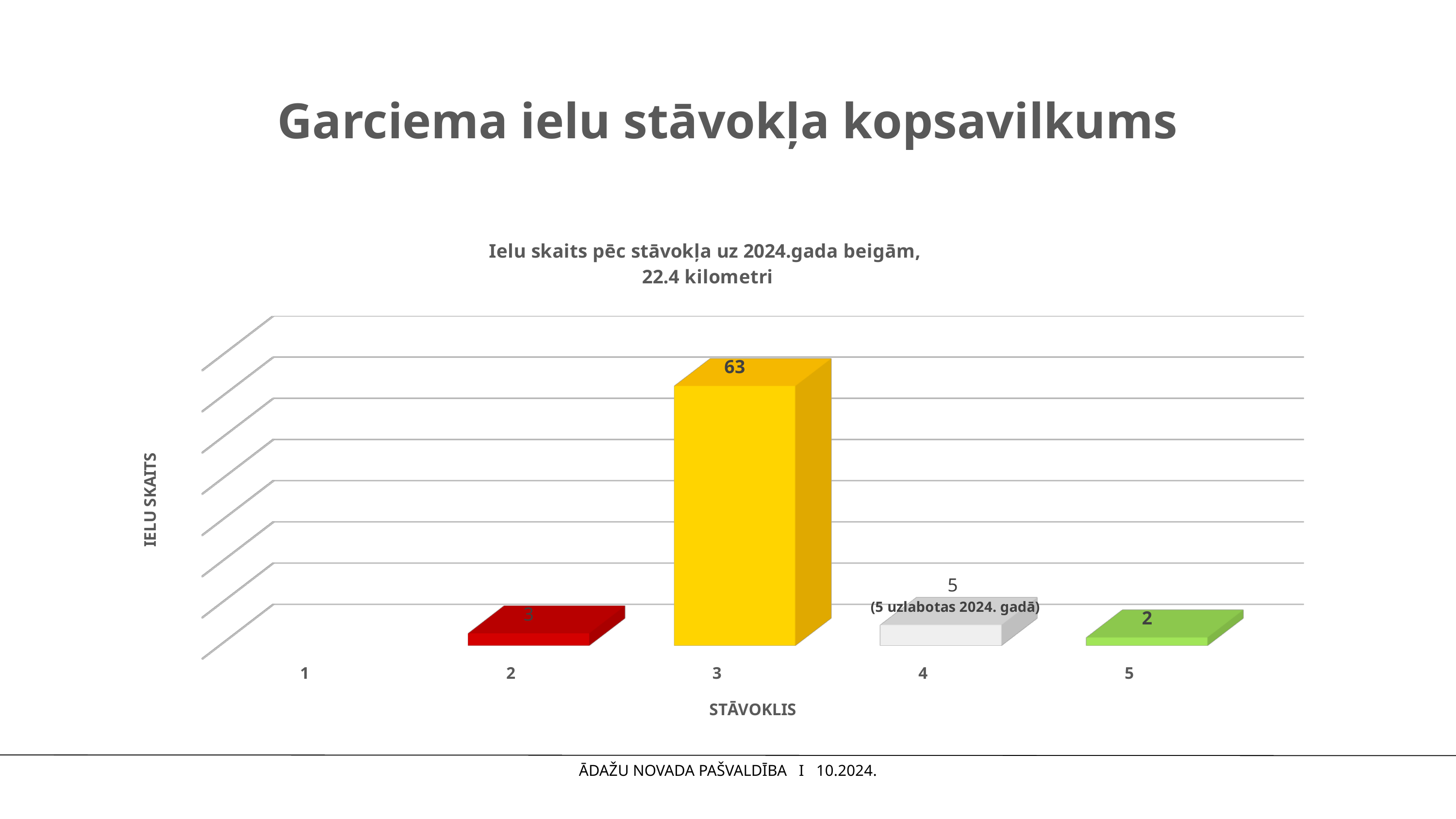
What kind of chart is shown on the slide? bar chart Which is larger, the value for condition 2 or the value for condition 4? condition 4 What is the value for condition (stāvoklis) 5? 2 What is the difference between the values for condition 3 and condition 4? 58 Which condition category has the highest number of streets? 3 What is the value for condition (stāvoklis) 2? 3 What is the title of the chart? Ielu skaits pēc stāvokļa uz 2024.gada beigām, 22.4 kilometri What is the value for condition (stāvoklis) 4? 5 What is the label of the x axis? STĀVOKLIS How many condition categories are shown on the x axis? 5 What is the difference between the values for condition 4 and condition 5? 3 What is the value for condition (stāvoklis) 3? 63